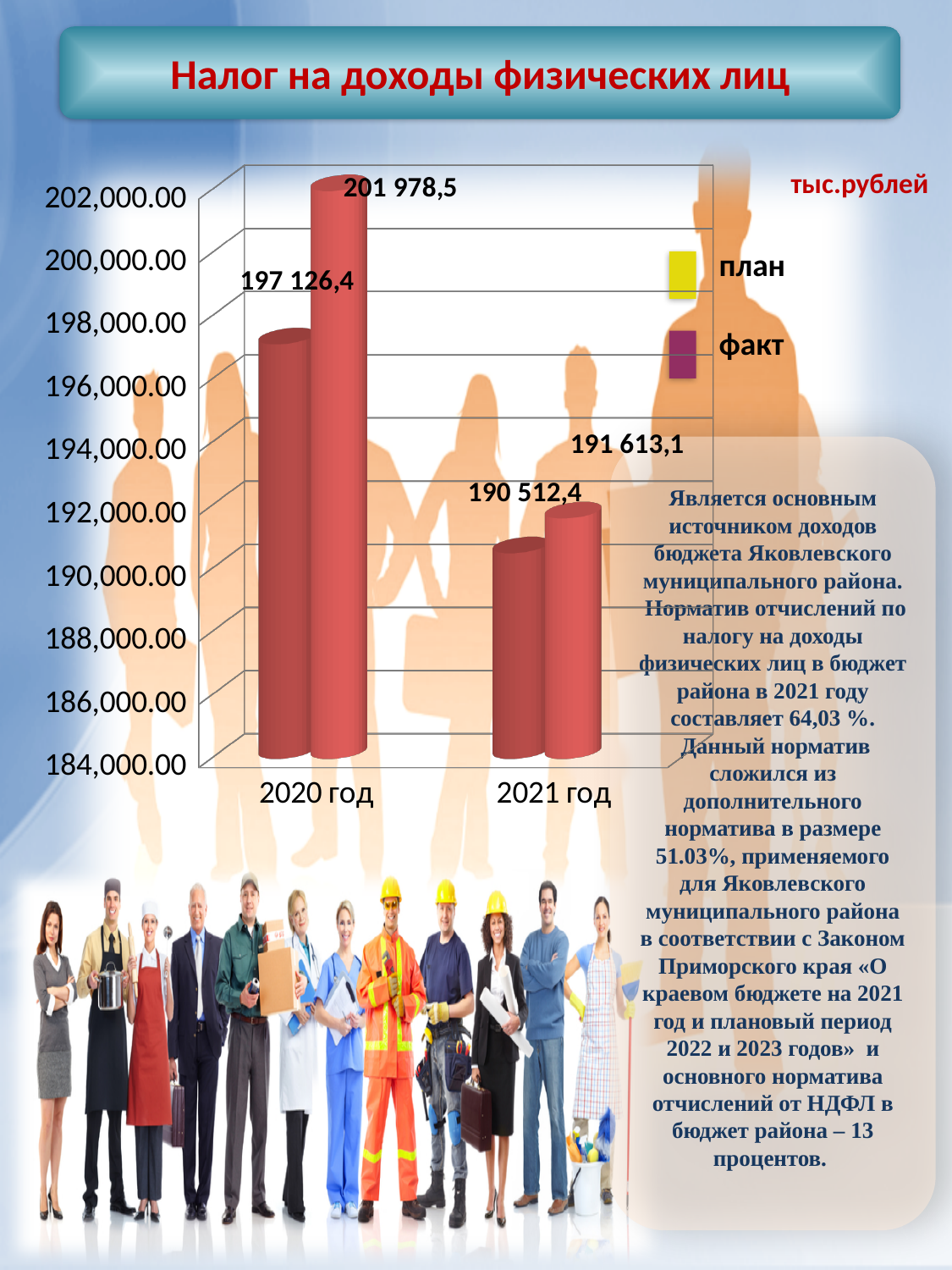
What is the факт value for 2020 год? 201 978,5 What is the план value for 2020 год? 197 126,4 What is the план value for 2021 год? 190 512,4 Which bar has the highest value on the chart? факт for 2020 год How many year categories are shown on the x axis? 2 Which bar has the lowest value on the chart? план for 2021 год What is the факт value for 2021 год? 191 613,1 Which is larger, the факт value for 2020 год or the факт value for 2021 год? факт for 2020 год What is the difference between the факт and план values for 2020 год? 4 852,1 What kind of chart is shown on the slide? bar chart What is the difference between the факт and план values for 2021 год? 1 100,7 How many series does the legend list? 2